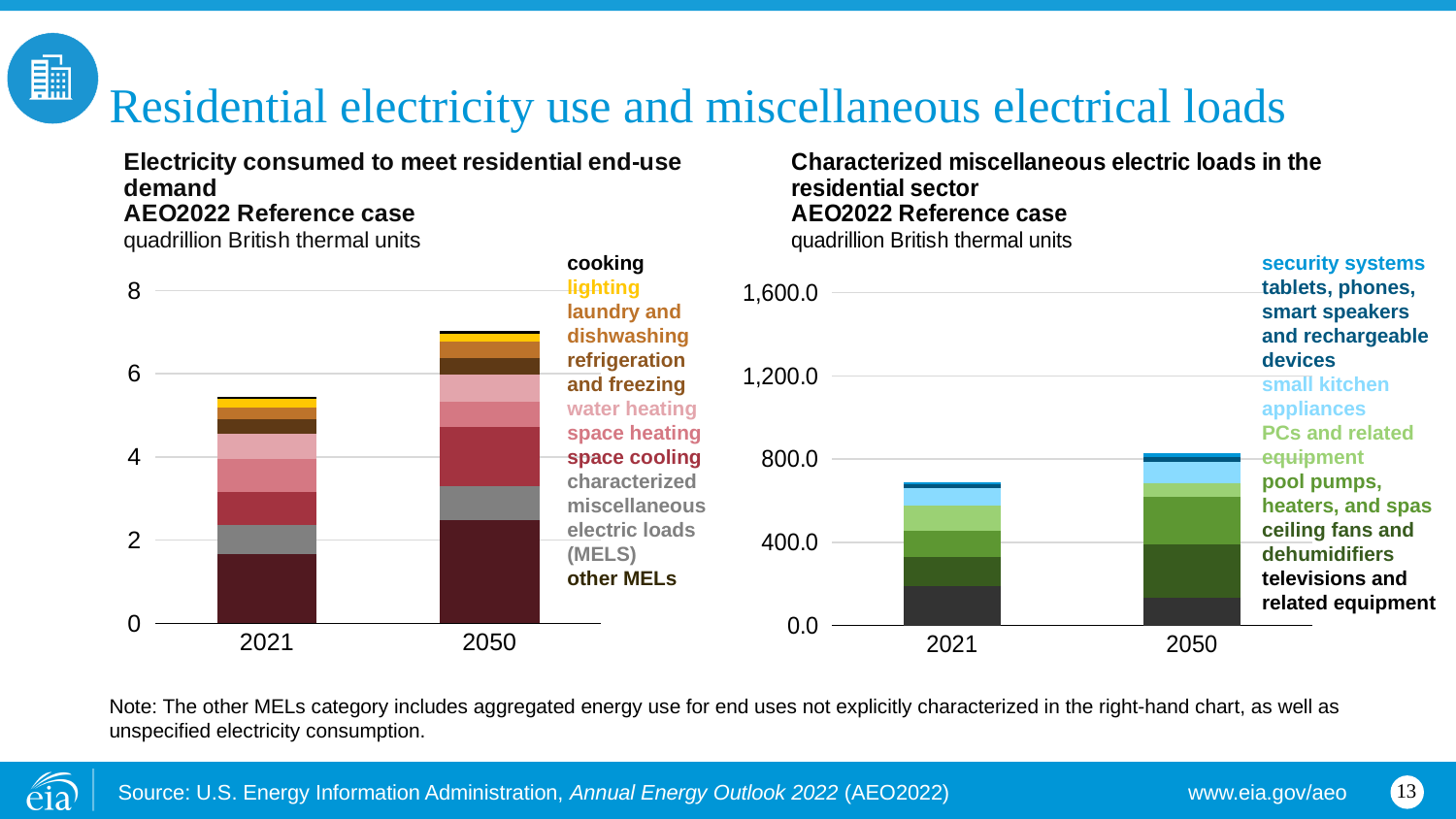
How many years are shown on the x axis of the left-hand chart, 'Electricity consumed to meet residential end-use demand'? 2 In the left-hand chart, 'Electricity consumed to meet residential end-use demand', is the total bar for 2050 greater or less than 6? greater In the left-hand chart, 'Electricity consumed to meet residential end-use demand', which year has the taller total bar, 2021 or 2050? 2050 In the left-hand chart, 'Electricity consumed to meet residential end-use demand', which series is shown at the bottom of each stacked bar? other MELs In the right-hand chart, 'Characterized miscellaneous electric loads in the residential sector', is the total bar for 2050 greater or less than 1,200.0? less What unit is used on the y axis of the right-hand chart, 'Characterized miscellaneous electric loads in the residential sector'? quadrillion British thermal units How many series does the legend of the right-hand chart, 'Characterized miscellaneous electric loads in the residential sector', list? 7 In the left-hand chart, 'Electricity consumed to meet residential end-use demand', is the total bar for 2021 greater or less than 6? less In the right-hand chart, 'Characterized miscellaneous electric loads in the residential sector', does the total bar rise or fall from 2021 to 2050? rise How many series does the legend of the left-hand chart, 'Electricity consumed to meet residential end-use demand', list? 9 What kind of chart is the left-hand chart, 'Electricity consumed to meet residential end-use demand'? Stacked bar chart